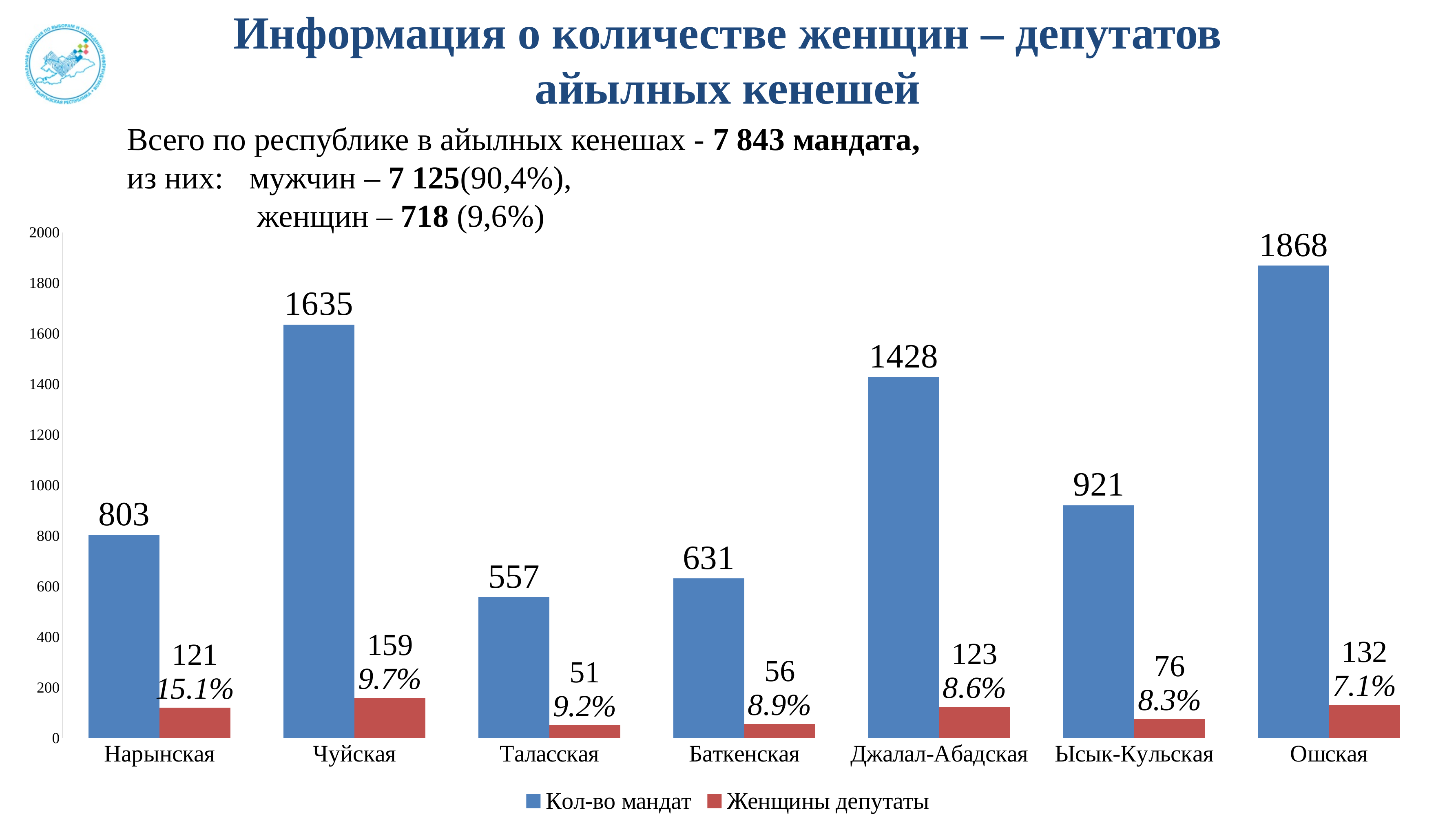
What colour are the "Женщины депутаты" bars? red What is the value of "Женщины депутаты" for Джалал-Абадская? 123 What is the value of "Кол-во мандат" for Чуйская? 1635 What kind of chart is shown on the slide? bar chart Which region has the highest value for "Кол-во мандат"? Ошская How many regions are shown on the x axis? 7 What percentage is shown above the "Женщины депутаты" bar for Нарынская? 15.1% Which is larger: the "Женщины депутаты" value for Нарынская or for Ысык-Кульская? Нарынская Is the "Кол-во мандат" value for Ысык-Кульская greater or less than 1000? less How many series does the legend list? 2 What is the difference between the "Кол-во мандат" values for Ошская and Чуйская? 233 Which region has the lowest value for "Женщины депутаты"? Таласская